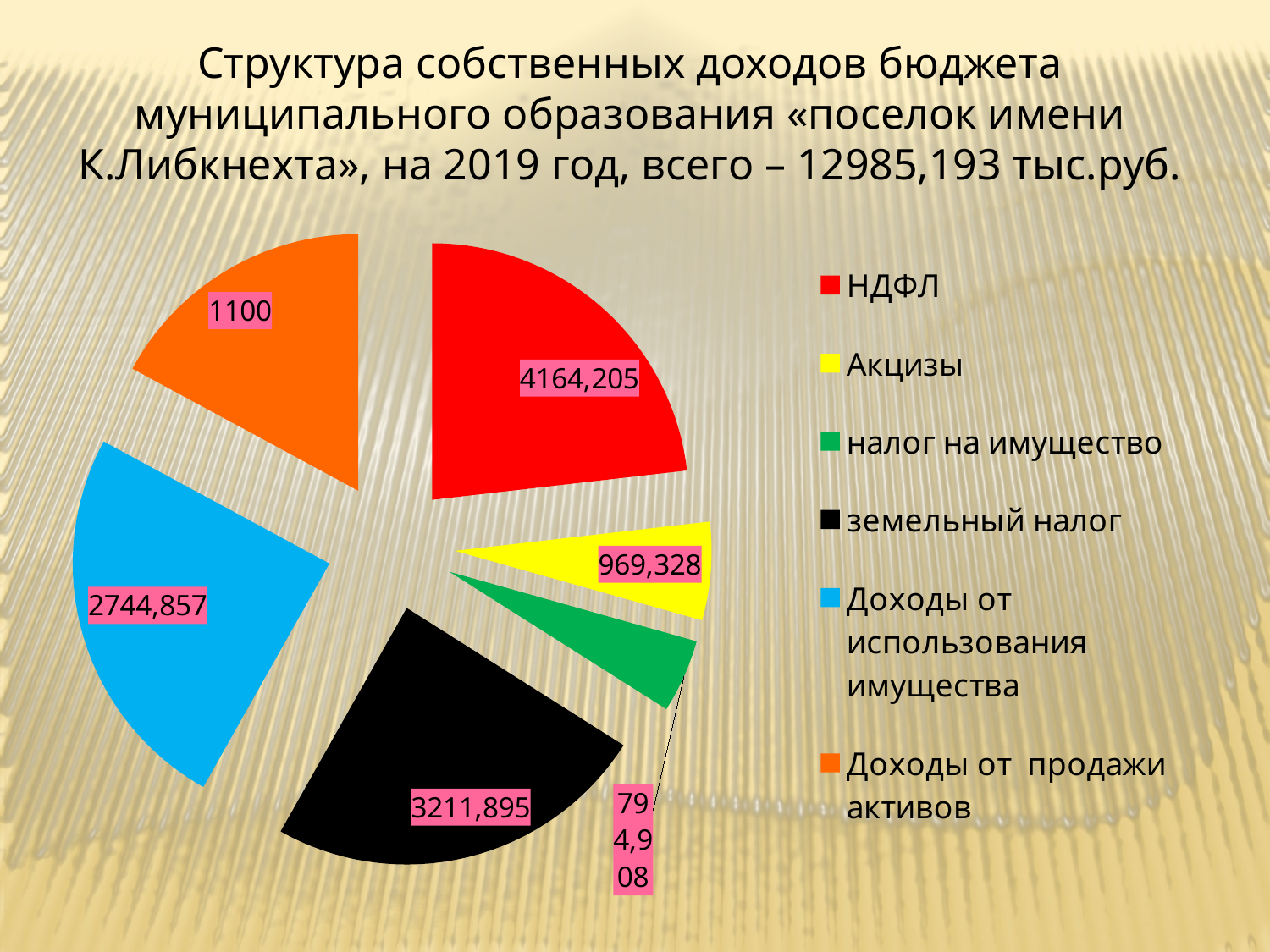
What is the value of the земельный налог slice? 3211,895 What is the value of the Акцизы slice? 969,328 What is the value of the Доходы от использования имущества slice? 2744,857 What is the value of the Доходы от продажи активов slice? 1100 How many slices does the pie chart have? 6 Which category has the smallest slice of the pie? налог на имущество What colour is the slice for Доходы от продажи активов? orange What is the value of the НДФЛ slice? 4164,205 What type of chart is shown on the slide? pie chart What is the difference between the НДФЛ value and the земельный налог value? 952,310